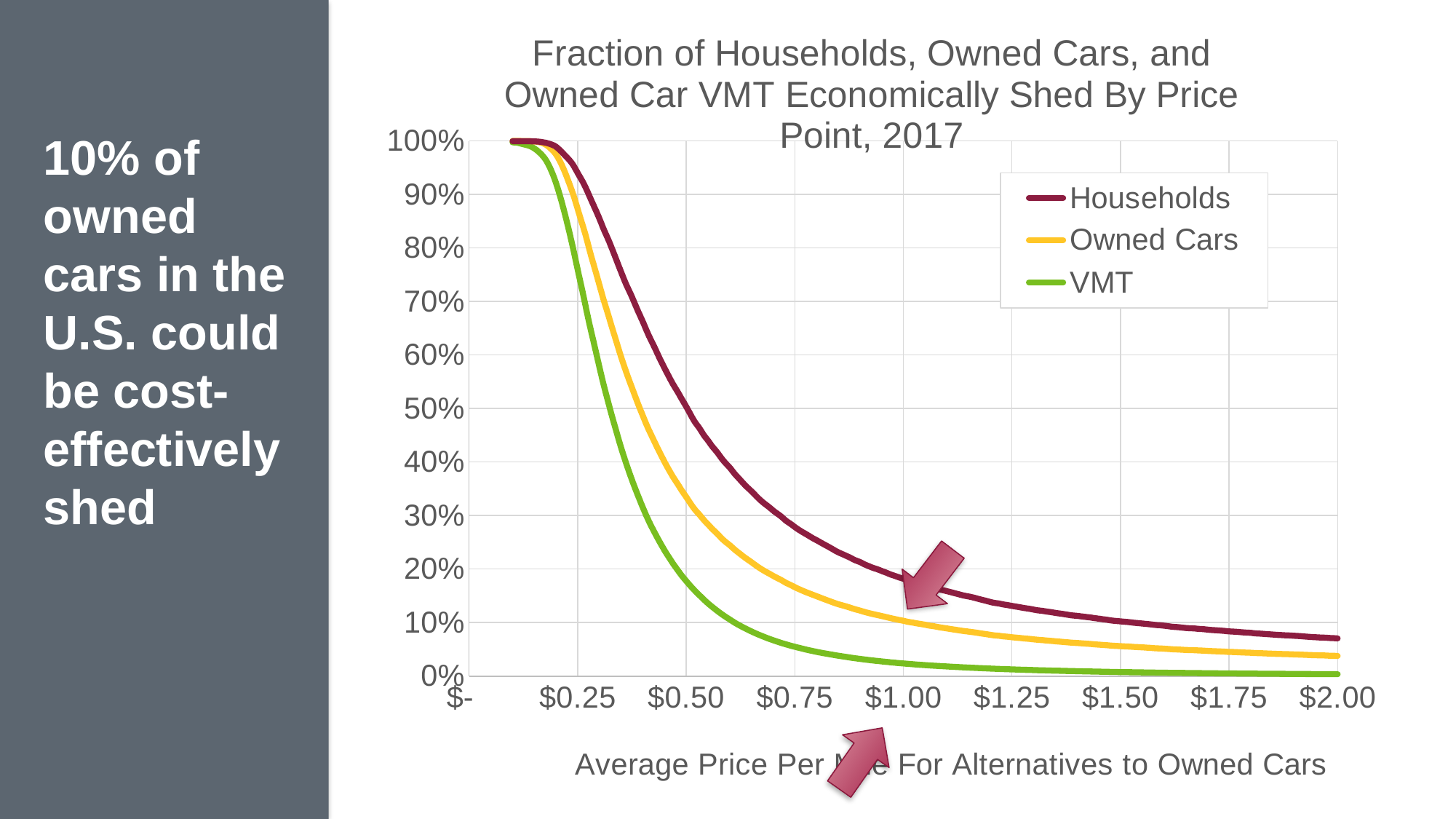
Do the values for Households rise or fall as the price per mile increases along the x axis? fall Is the value for Households at $0.50 greater or less than 40%? greater Which series has the highest value at $1.50? Households Is the value for VMT at $0.50 greater or less than 30%? less Is the value for VMT at $1.00 greater or less than 10%? less What is the label of the x axis? Average Price Per Mile For Alternatives to Owned Cars What kind of chart is shown on the slide? line chart At $0.50, which is larger: the value for Owned Cars or the value for VMT? Owned Cars At $1.00, which is larger: the value for Households or the value for VMT? Households How many series does the legend list? 3